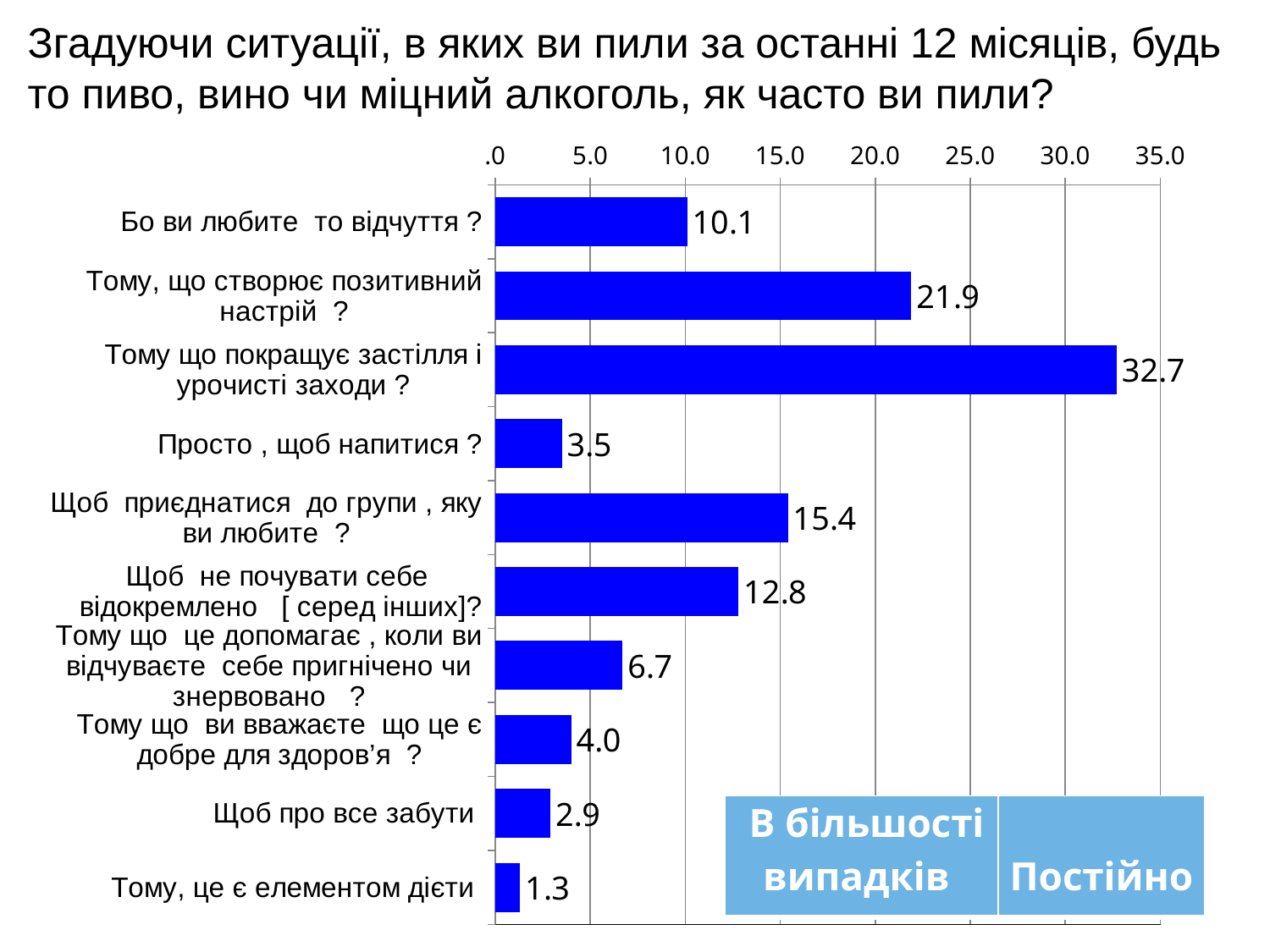
What is the difference between the values for "Тому, що створює позитивний настрій ?" and "Бо ви любите то відчуття ?"? 11.8 What is the value for "Щоб про все забути"? 2.9 What is the value for "Тому що покращує застілля і урочисті заходи ?"? 32.7 What is the value for "Тому, це є елементом дієти"? 1.3 What is the value for "Щоб приєднатися до групи , яку ви любите ?"? 15.4 Which is larger: the value for "Щоб не почувати себе відокремлено [ серед інших]?" or for "Тому що це допомагає , коли ви відчуваєте себе пригнічено чи знервовано ?"? Щоб не почувати себе відокремлено [ серед інших]? What is the value for "Просто , щоб напитися ?"? 3.5 Is the value for "Тому, що створює позитивний настрій ?" greater or less than 20.0? greater What kind of chart is shown on the slide? bar chart Which category has the lowest value? Тому, це є елементом дієти How many categories are shown in the chart? 10 Which category has the highest value? Тому що покращує застілля і урочисті заходи ?